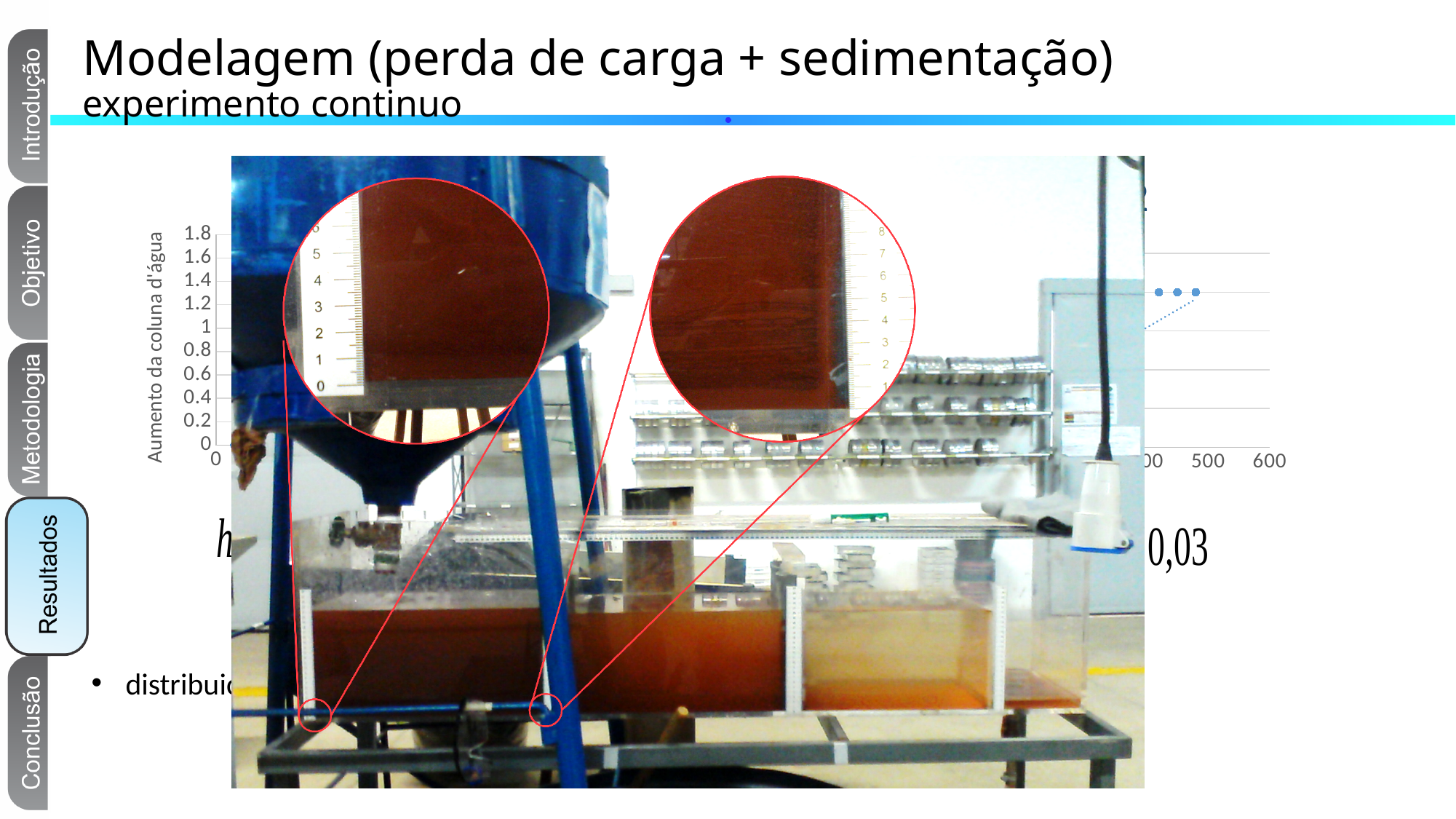
Are the visible data points near the 500 mark on the horizontal axis greater or less than 1 on the vertical axis? greater What is the highest tick value shown on the horizontal axis of the chart? 600 Are the visible data points near the 500 mark on the horizontal axis greater or less than 1.6 on the vertical axis? less What is the label on the vertical axis of the chart behind the photo? Aumento da coluna d'água